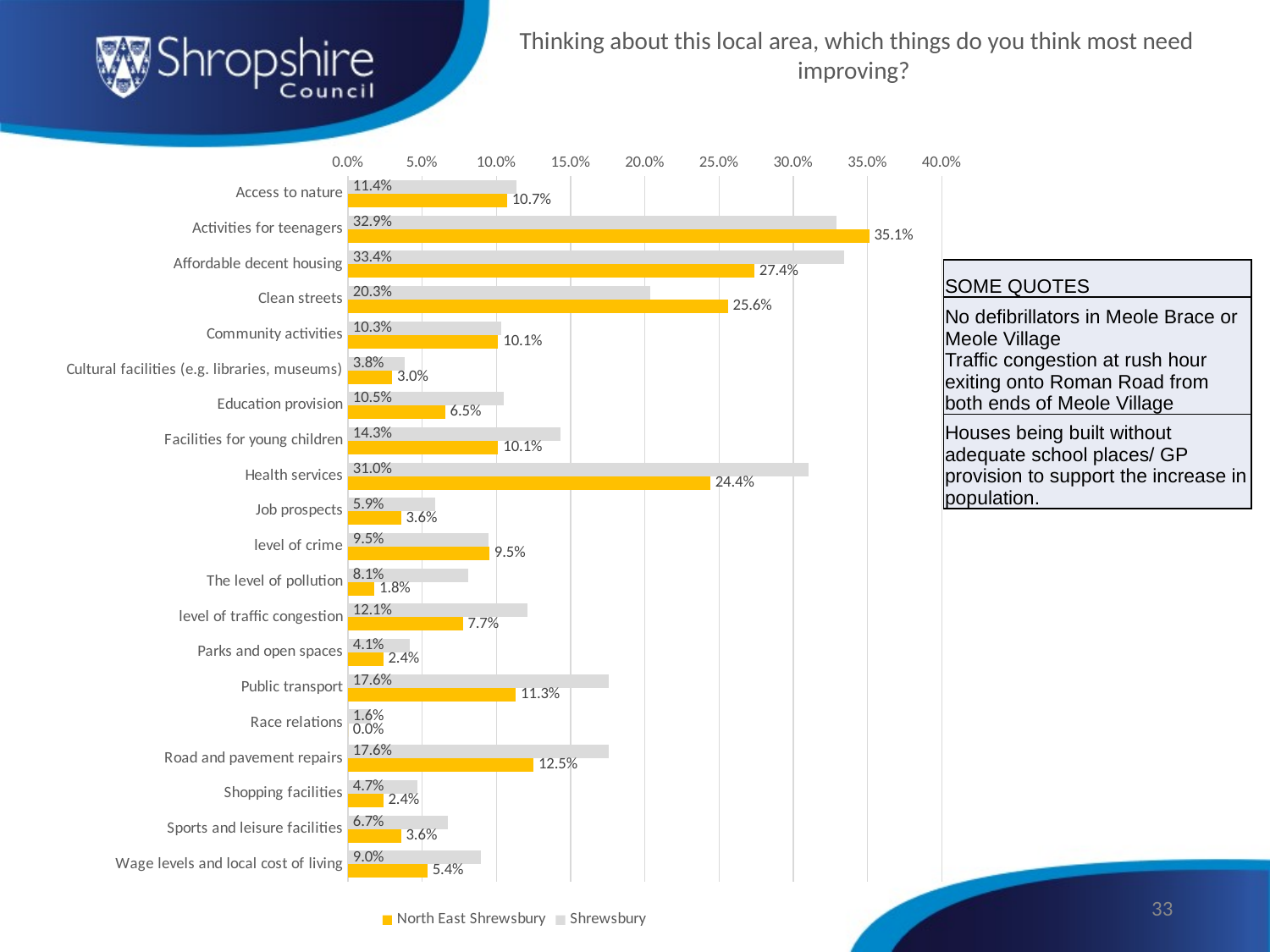
What is the North East Shrewsbury value for The level of pollution? 1.8% How many categories are shown on the chart? 20 What is the Shrewsbury value for Health services? 31.0% Which colour represents the Shrewsbury series in the chart? Grey Which category has the lowest North East Shrewsbury value? Race relations What is the North East Shrewsbury value for Activities for teenagers? 35.1% For Clean streets, which is larger: the North East Shrewsbury value or the Shrewsbury value? North East Shrewsbury Which category has the highest North East Shrewsbury value? Activities for teenagers What type of chart is shown on the slide? Bar chart What is the difference between the Shrewsbury and North East Shrewsbury values for Public transport? 6.3% Which category has the highest Shrewsbury value? Affordable decent housing How many series does the legend list? 2